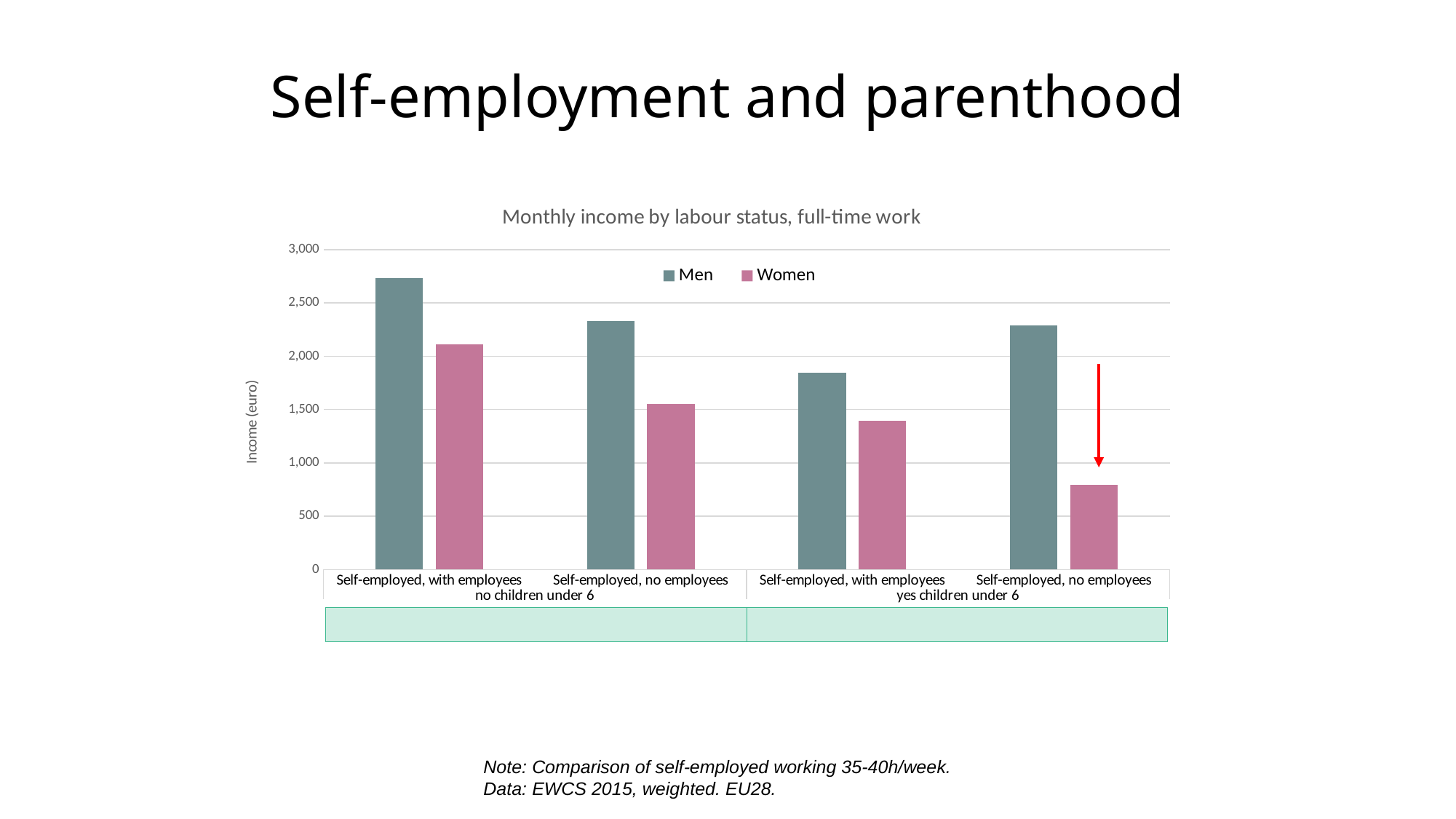
Which is larger: the Women value for 'Self-employed, with employees' with no children under 6, or the Women value for 'Self-employed, no employees' with no children under 6? Self-employed, with employees (no children under 6) Which category has the highest value for Men? Self-employed, with employees (no children under 6) Is the value for Men in 'Self-employed, with employees' with children under 6 greater or less than 2,000? less Is the value for Men in 'Self-employed, with employees' with no children under 6 greater or less than 2,500? greater How many series does the legend list? 2 What kind of chart is shown on the slide? bar chart How many labour-status categories are shown on the x axis? 4 What is the title of the chart? Monthly income by labour status, full-time work Is the value for Women in 'Self-employed, no employees' with children under 6 greater or less than 1,000? less Which category has the lowest value for Women? Self-employed, no employees (yes children under 6) What are the two series named in the legend? Men and Women Which is larger in the 'Self-employed, no employees, yes children under 6' category: Men or Women? Men